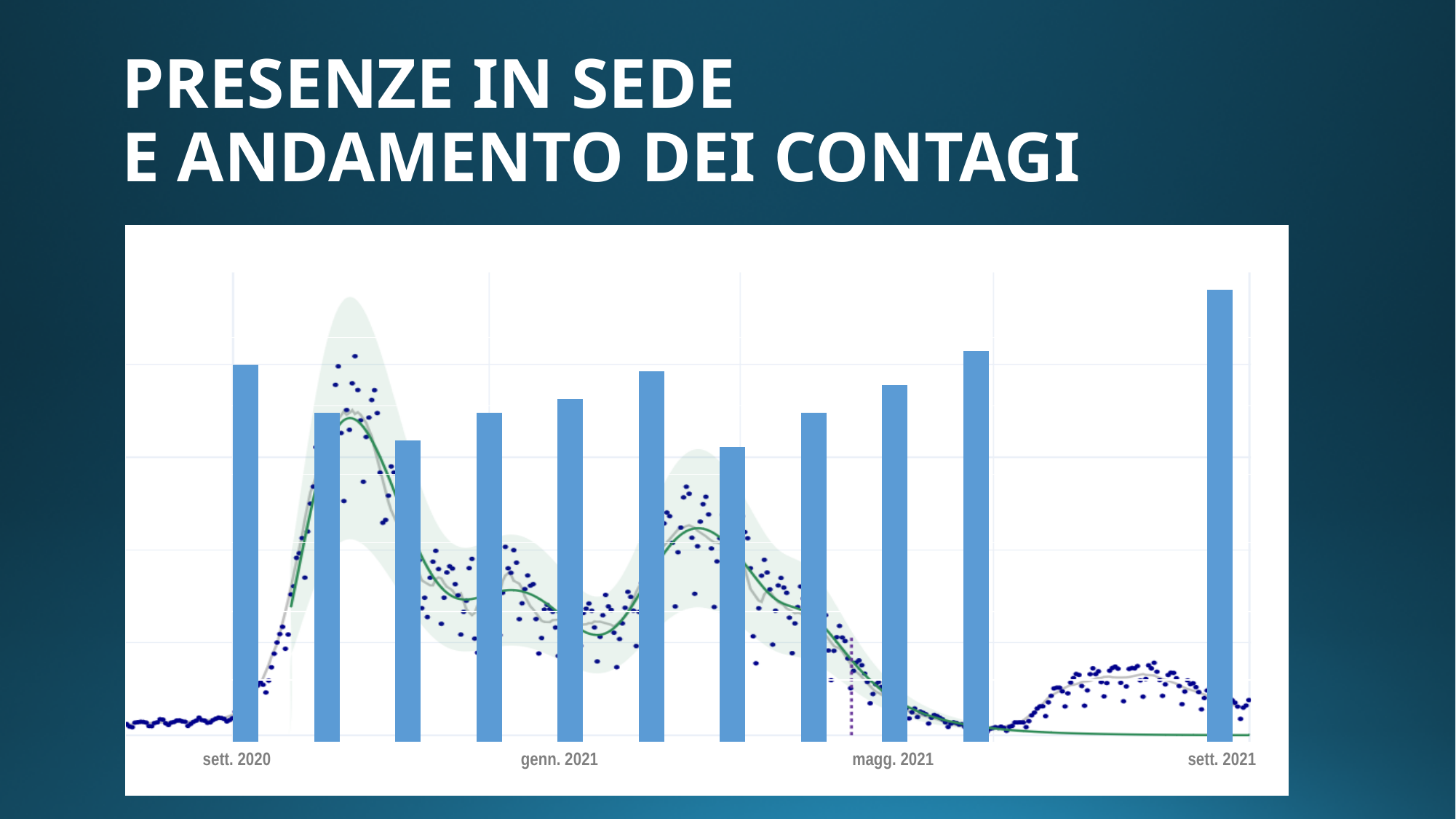
What is the title of the slide containing the chart? PRESENZE IN SEDE E ANDAMENTO DEI CONTAGI Which is taller: the blue bar at sett. 2020 or the blue bar at genn. 2021? sett. 2020 Which is taller: the first blue bar or the second blue bar from the left? The first bar What kind of chart is shown on the slide? A bar chart combined with a scatter/line chart Which x-axis label is the tallest blue bar located at? sett. 2021 How many labels are shown on the x axis of the chart? 4 What is the first label on the x axis of the chart? sett. 2020 Does the green contagion trend line rise or fall immediately after sett. 2020? Rise How many blue bars are plotted on the chart? 11 Does the green contagion trend line rise or fall between magg. 2021 and sett. 2021? Fall Which is taller: the blue bar at sett. 2020 or the blue bar at sett. 2021? sett. 2021